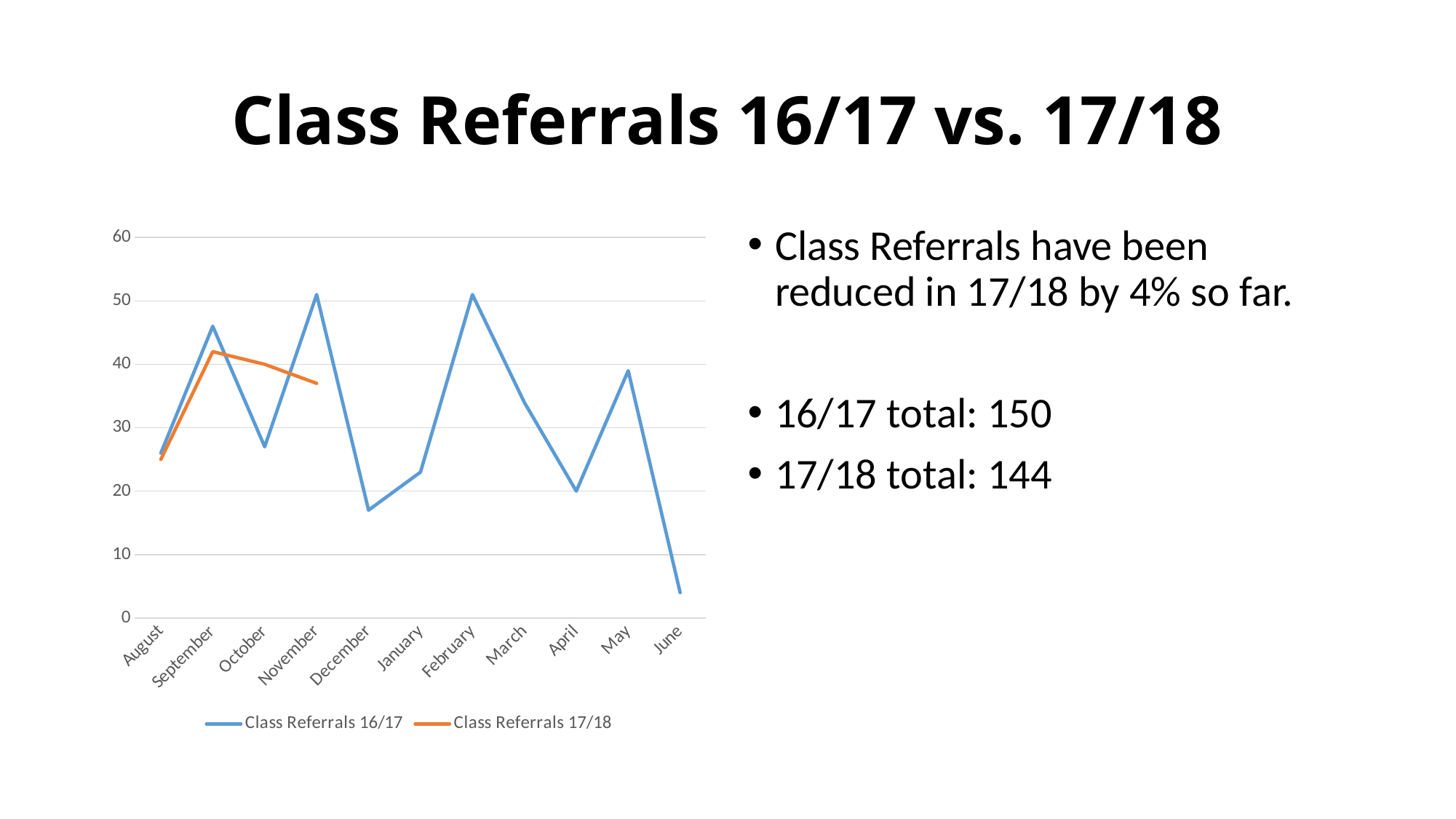
How many series does the chart legend list? 2 Which month has the lowest value for Class Referrals 16/17? June Does the Class Referrals 17/18 line rise or fall from September to November? Fall Is the value for Class Referrals 16/17 in September greater or less than 40? greater In November, which series has the higher value, Class Referrals 16/17 or Class Referrals 17/18? Class Referrals 16/17 How many months are shown along the x axis of the chart? 11 Is the value for Class Referrals 17/18 in November greater or less than 30? greater What kind of chart is shown on the slide? Line chart What colour is the Class Referrals 17/18 line in the chart? Orange Is the value for Class Referrals 16/17 in December greater or less than 20? less Which month has the lowest value for Class Referrals 17/18? August In October, which series has the higher value, Class Referrals 16/17 or Class Referrals 17/18? Class Referrals 17/18